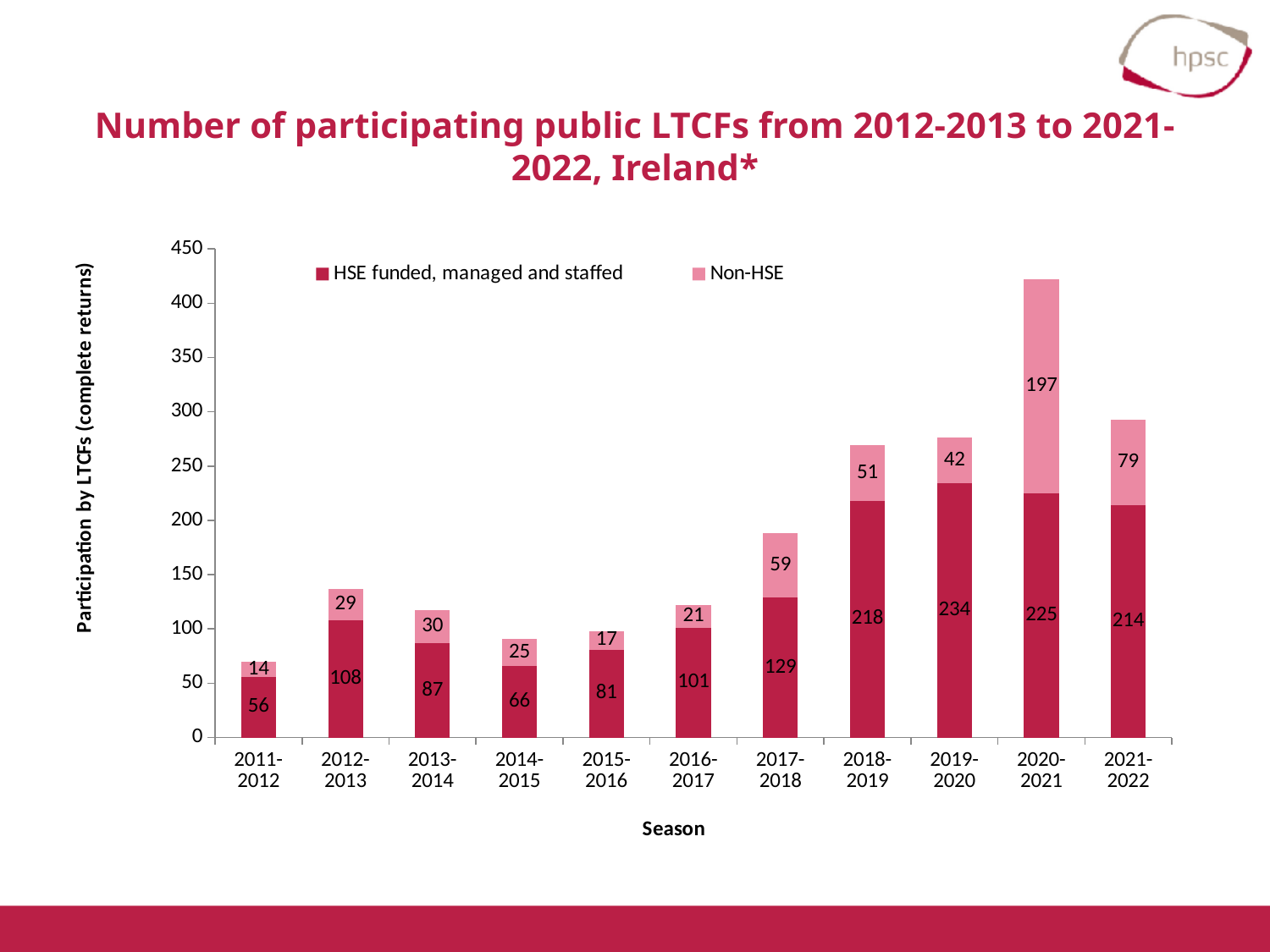
How many seasons are shown on the x axis? 11 How many series does the legend list? 2 What is the total number of participating LTCFs in the 2017-2018 season (both series combined)? 188 Which season has the highest Non-HSE value? 2020-2021 What kind of chart is shown on the slide? Stacked bar chart What is the Non-HSE value for the 2020-2021 season? 197 What is the HSE funded, managed and staffed value for the 2011-2012 season? 56 What is the value for HSE funded, managed and staffed LTCFs in the 2019-2020 season? 234 Which season has the lowest HSE funded, managed and staffed value? 2011-2012 What is the total number of participating LTCFs in the 2020-2021 season (both series combined)? 422 Which is larger: the HSE funded, managed and staffed value for 2018-2019 or for 2021-2022? 2018-2019 What is the difference between the Non-HSE values for 2021-2022 and 2019-2020? 37